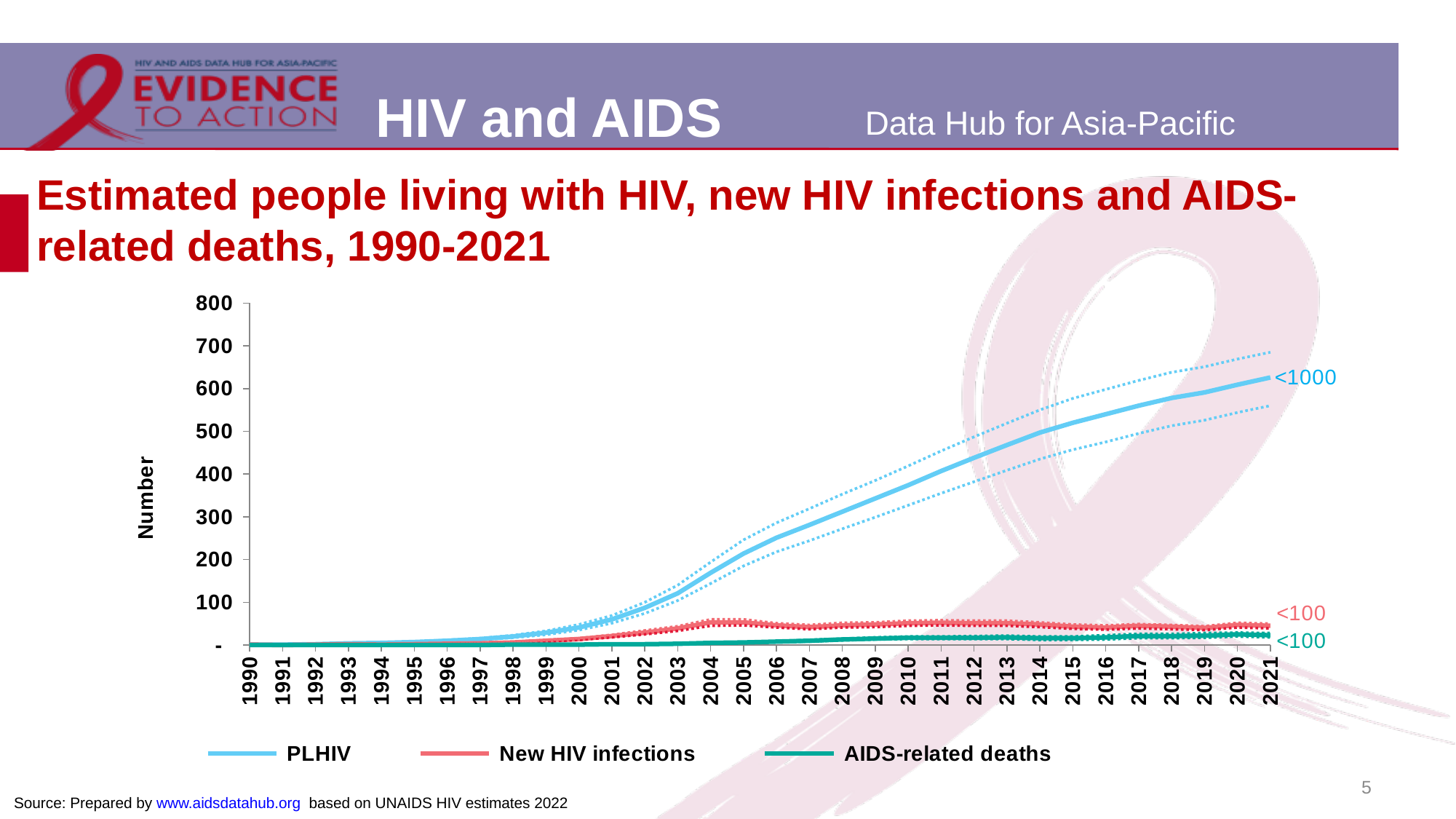
Is the PLHIV value in 2021 greater or less than 500? greater Which series has the lowest value in 2021? AIDS-related deaths What data label is printed at the end of the PLHIV line in 2021? <1000 Which series has the highest value in 2021? PLHIV How many years are shown along the x axis? 32 What kind of chart is shown on the slide? line chart In 2021, which is larger: PLHIV or New HIV infections? PLHIV Does the PLHIV line rise or fall from 1990 to 2021? rise Is the PLHIV value in 2000 greater or less than 100? less What is the label on the y axis? Number How many series does the legend list? 3 Is the value for New HIV infections in 2021 greater or less than 100? less